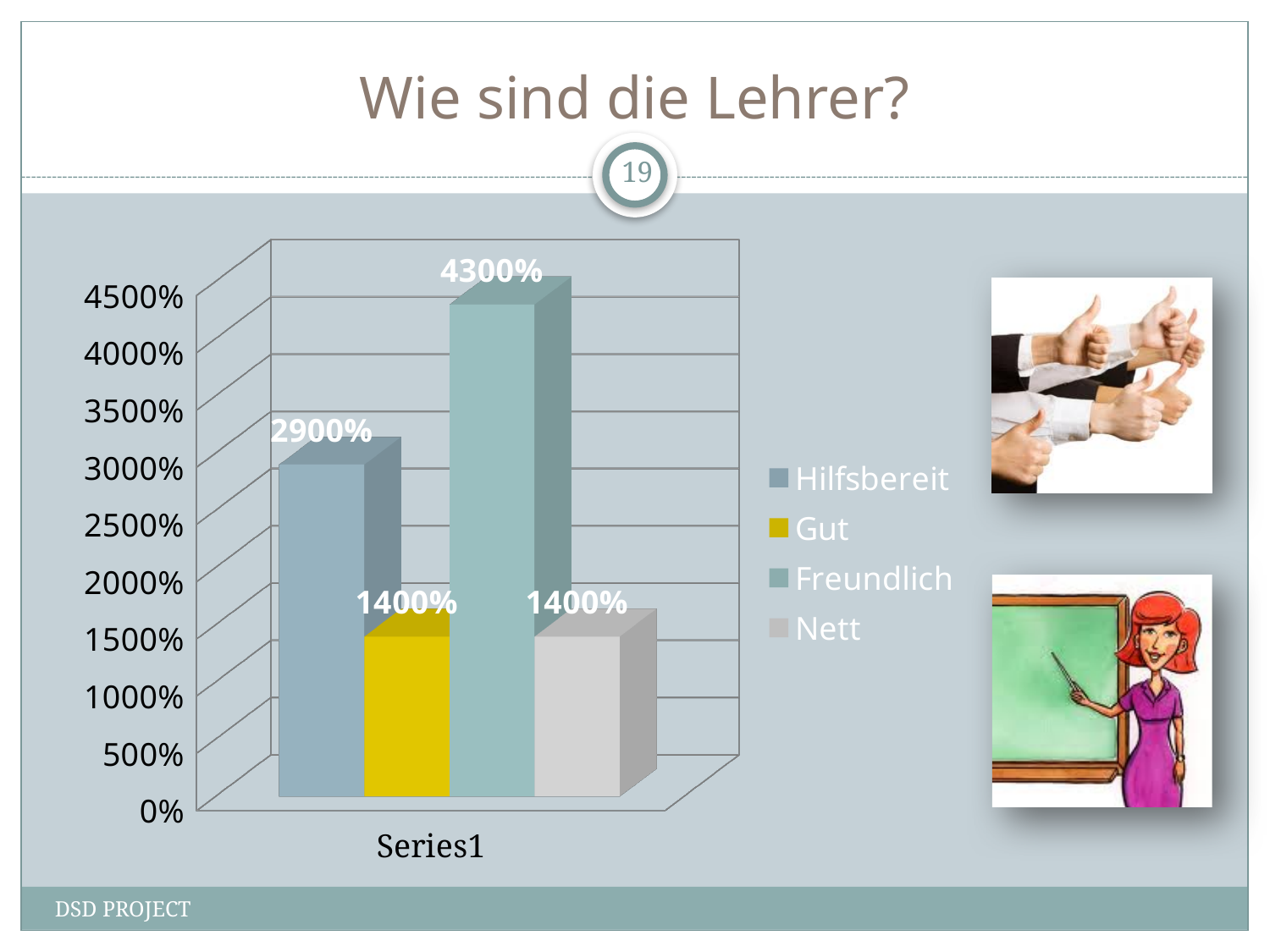
How many entries does the legend list? 4 What kind of chart is shown on the slide? bar chart What is the value for Hilfsbereit? 2900% What is the value for Gut? 1400% Is the value for Freundlich greater or less than 4000%? greater What is the value for Nett? 1400% What is the title of the slide containing the chart? Wie sind die Lehrer? What is the difference between the values for Freundlich and Hilfsbereit? 1400% Which is larger, the value for Hilfsbereit or the value for Nett? Hilfsbereit Which category has the highest value? Freundlich What is the difference between the values for Hilfsbereit and Gut? 1500% What is the value for Freundlich? 4300%